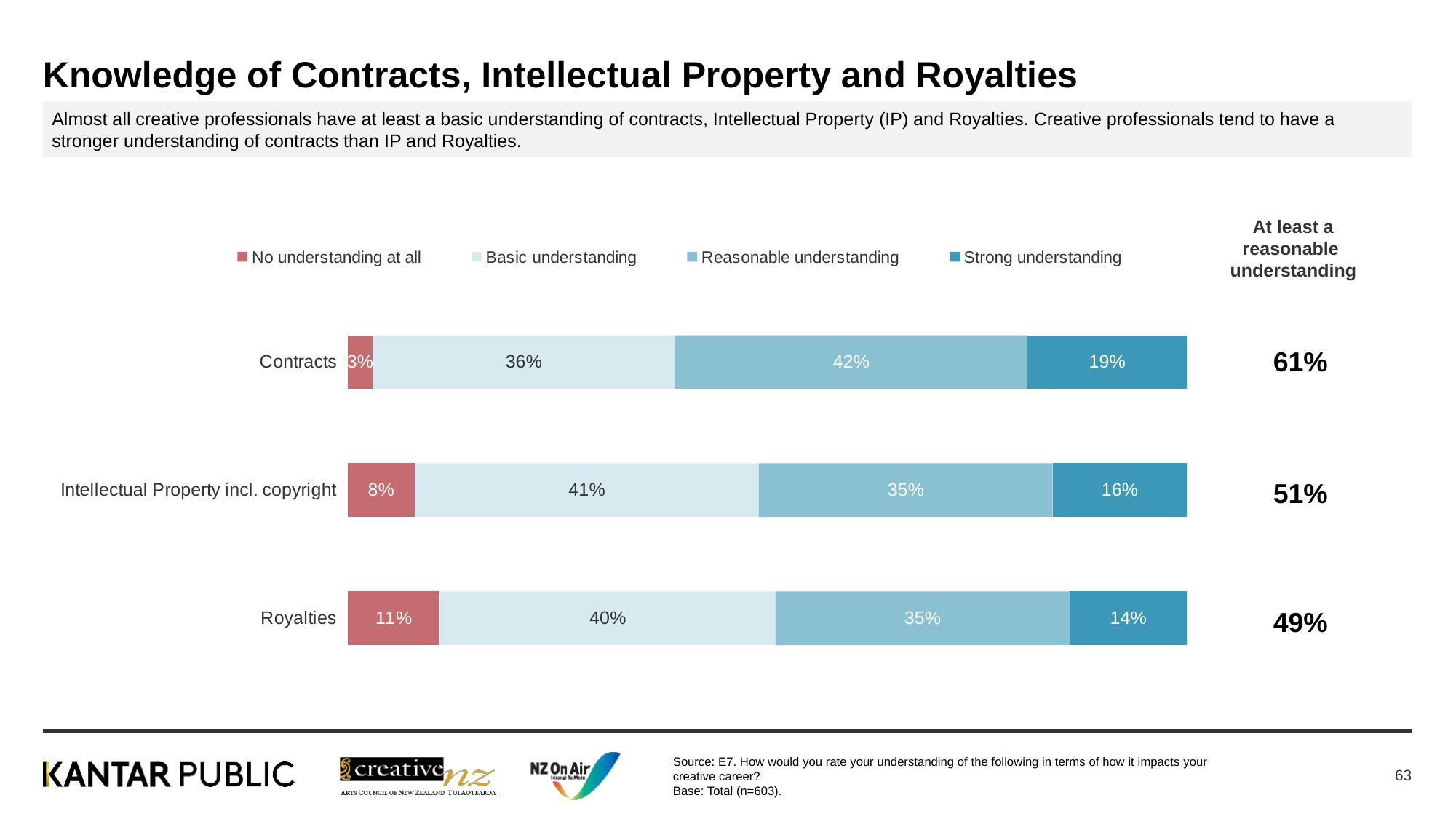
How many series does the legend list? 4 What is the 'At least a reasonable understanding' figure for Contracts? 61% What percentage of creative professionals have a strong understanding of Contracts? 19% How many categories are shown in the chart? 3 Which is larger: the reasonable understanding share for Contracts or for Intellectual Property incl. copyright? Contracts Which legend entry is shown in red? No understanding at all What kind of chart is shown on the slide? Stacked bar chart What percentage have no understanding at all of Royalties? 11% What is the difference between the 'At least a reasonable understanding' figures for Contracts and Royalties? 12 percentage points Which category has the lowest share of respondents with a strong understanding? Royalties What percentage have a basic understanding of Intellectual Property incl. copyright? 41% Which category has the highest share of respondents with no understanding at all? Royalties